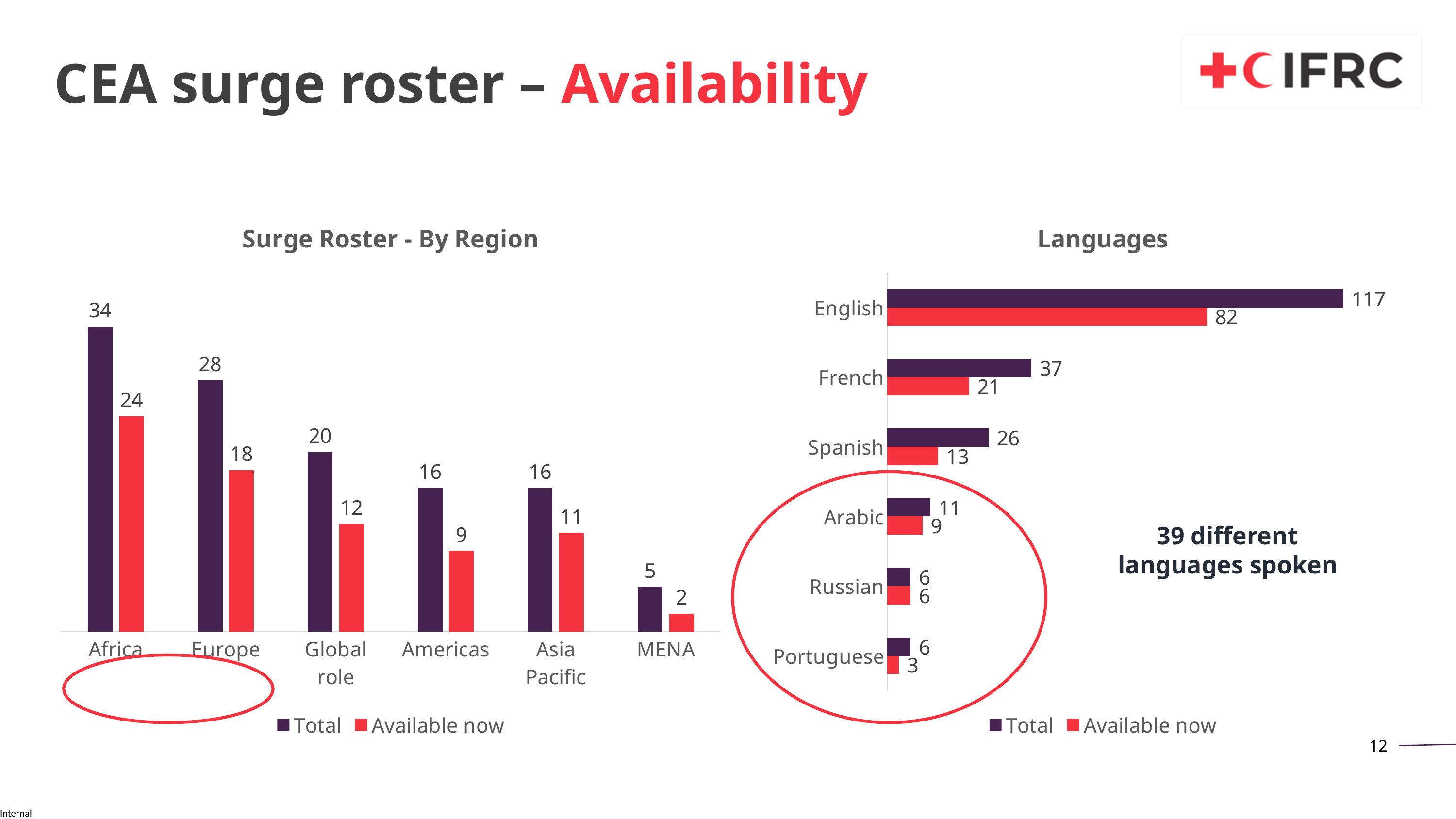
In the 'Surge Roster - By Region' chart, is the Available now value for Americas larger or smaller than the Available now value for Asia Pacific? smaller In the 'Surge Roster - By Region' chart, what is the difference between the Total and Available now values for Global role? 8 In the 'Languages' chart, what is the Total value for English? 117 In the 'Surge Roster - By Region' chart, which region has the lowest Total value? MENA In the 'Languages' chart, which language has the highest Available now value? English In the 'Languages' chart, how many series does the legend list? 2 What kind of chart is the 'Languages' chart? Bar chart In the 'Surge Roster - By Region' chart, what is the Total value for Africa? 34 In the 'Surge Roster - By Region' chart, how many regions are shown on the x axis? 6 In the 'Surge Roster - By Region' chart, what is the Available now value for Europe? 18 In the 'Languages' chart, what is the difference between the Total and Available now values for French? 16 In the 'Languages' chart, what is the Available now value for Spanish? 13